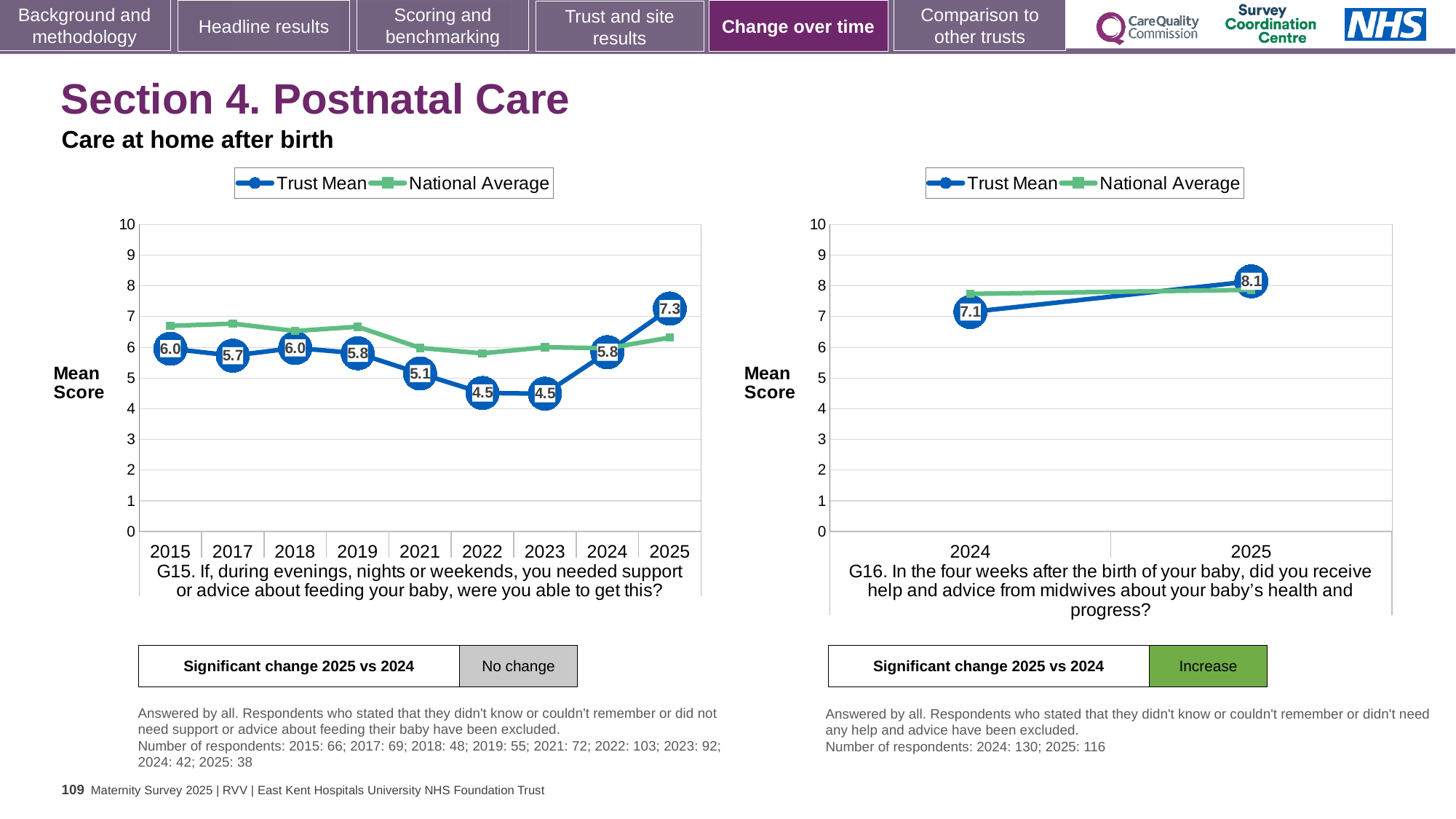
In the G15 chart on the left, what is the difference between the Trust Mean scores for 2025 and 2024? 1.5 How many years are plotted on the x axis of the G15 chart on the left? 9 How many series does the legend of the G16 chart on the right list? 2 In the G15 chart on the left, what is the Trust Mean score for 2025? 7.3 In the G16 chart on the right, what is the difference between the Trust Mean scores for 2025 and 2024? 1.0 In the G15 chart on the left, is the National Average for 2015 greater or less than 6? greater In the G15 chart on the left, what is the Trust Mean score for 2021? 5.1 In the G15 chart on the left, which is larger: the Trust Mean for 2018 or for 2019? 2018 In the G16 chart on the right, what is the Trust Mean score for 2024? 7.1 What kind of chart is the G16 chart on the right? Line chart In the G15 chart on the left, what is the lowest Trust Mean score shown? 4.5 In the G15 chart on the left, which year has the highest Trust Mean score? 2025